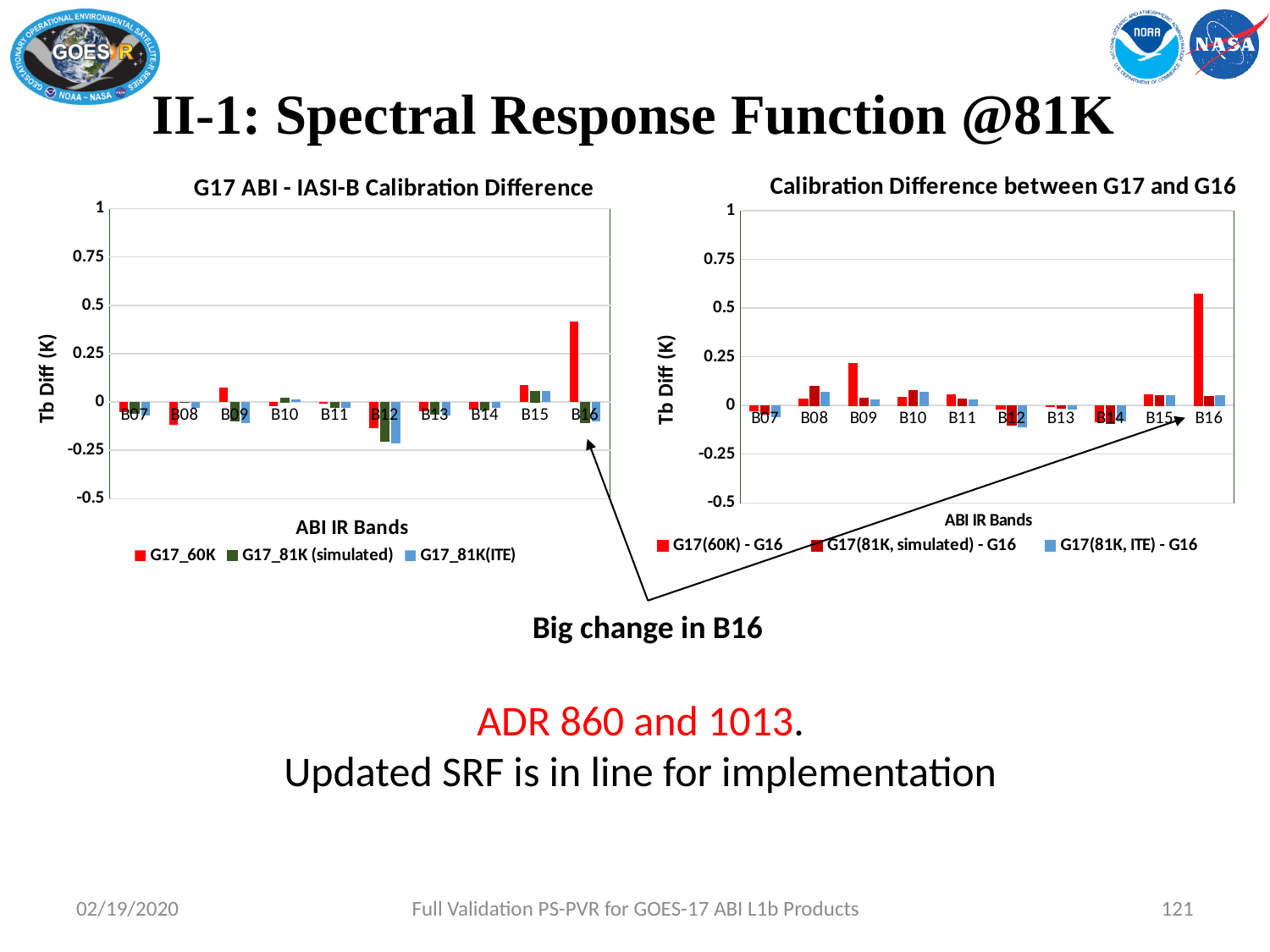
In the left chart (G17 ABI - IASI-B Calibration Difference), how many series does the legend list? 3 In the right chart (Calibration Difference between G17 and G16), is the G17(60K) - G16 value for B16 greater or less than 0.5? greater In the right chart (Calibration Difference between G17 and G16), is the G17(60K) - G16 value for B09 greater or less than 0.25? less In the left chart (G17 ABI - IASI-B Calibration Difference), which band has the highest G17_60K value? B16 In the left chart (G17 ABI - IASI-B Calibration Difference), is the G17_60K value for B16 greater or less than 0.25? greater In the right chart (Calibration Difference between G17 and G16), which is larger for the G17(60K) - G16 series: B09 or B16? B16 In the right chart (Calibration Difference between G17 and G16), which band has the highest G17(60K) - G16 value? B16 In the left chart (G17 ABI - IASI-B Calibration Difference), what is the label of the y axis? Tb Diff (K) In the right chart (Calibration Difference between G17 and G16), how many series does the legend list? 3 What kind of chart is the left chart titled "G17 ABI - IASI-B Calibration Difference"? bar chart In the left chart (G17 ABI - IASI-B Calibration Difference), how many ABI IR bands are shown on the x axis? 10 In the left chart (G17 ABI - IASI-B Calibration Difference), which band has the lowest G17_81K (simulated) value? B12